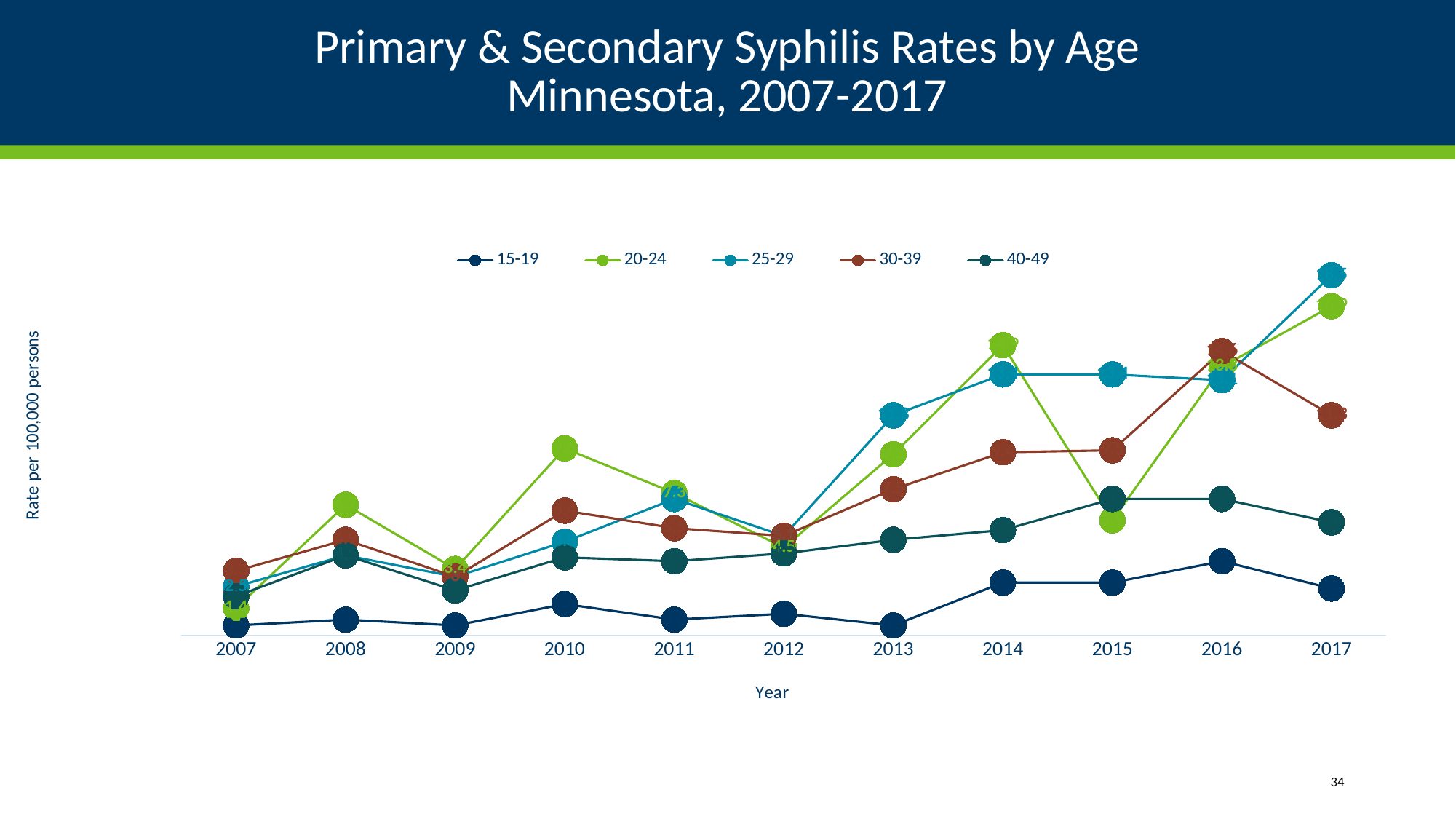
Does the rate for the 30-39 age group rise or fall from 2016 to 2017? fall Which age group has the lowest rate in 2013? 15-19 Which age group has the highest rate in 2014? 20-24 Which age group has the highest rate in 2010? 20-24 Does the rate for the 40-49 age group generally rise or fall from 2007 to 2017? rise How many years are shown along the x axis? 11 How many series does the legend list? 5 Which age group has the highest rate in 2017? 25-29 In 2015, which is higher: the rate for 30-39 or the rate for 20-24? 30-39 In 2017, which is higher: the rate for 30-39 or the rate for 40-49? 30-39 What kind of chart is shown on the slide? line chart What is the label on the y axis of the chart? Rate per 100,000 persons